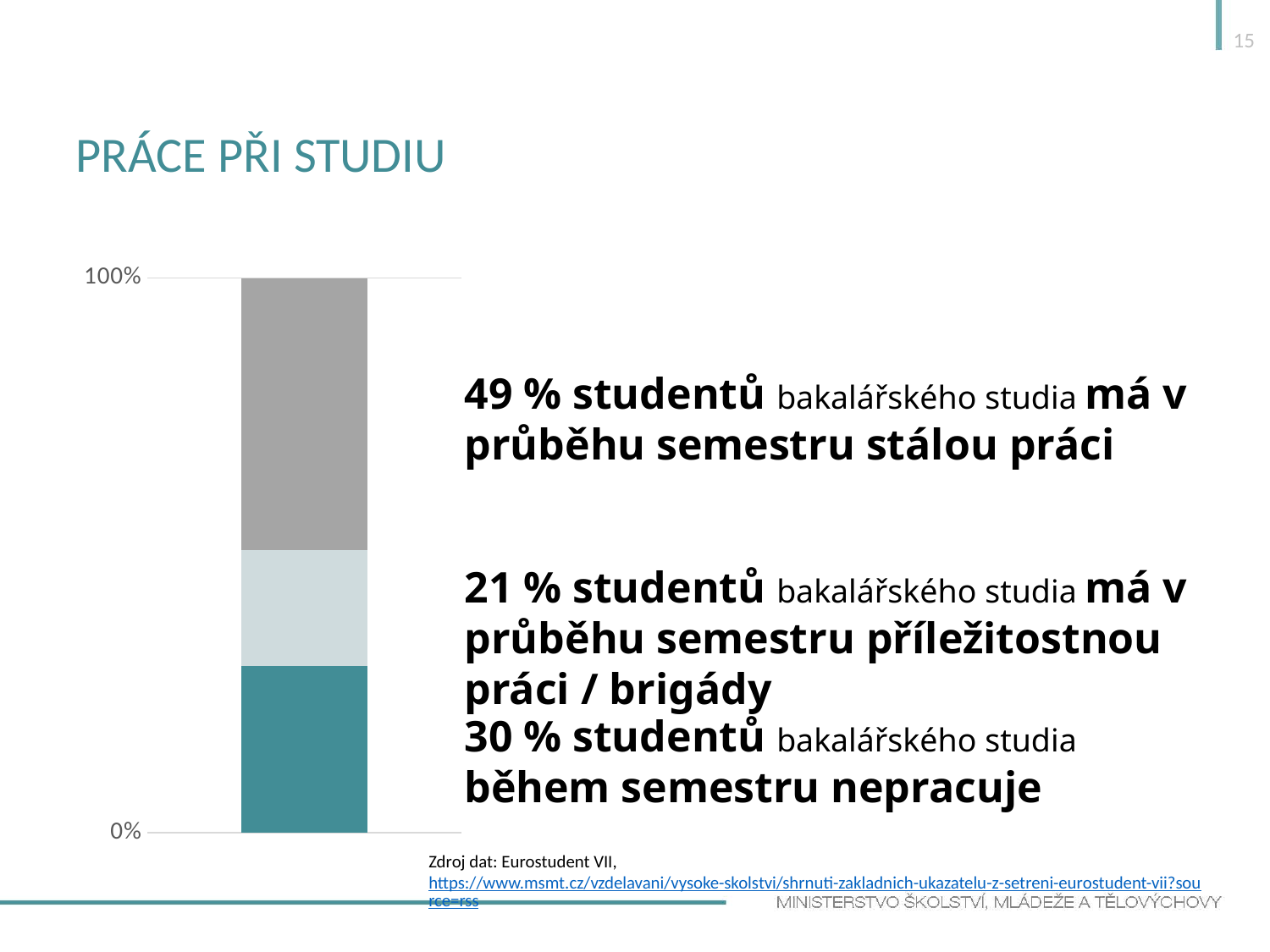
Which segment of the stacked bar is the smallest: the top grey, the middle light grey, or the bottom teal? the middle light grey segment Is the top grey segment of the bar larger or smaller than the bottom teal segment? larger How many bars does the chart contain? 1 Which segment of the stacked bar is the largest: the top grey, the middle light grey, or the bottom teal? the top grey segment What kind of chart is shown on the slide? stacked bar chart What is the total height of the stacked bar according to the y axis? 100% What is the title of the slide containing the chart? PRÁCE PŘI STUDIU How many segments make up the stacked bar? 3 What are the two tick labels shown on the y axis of the chart? 0% and 100%